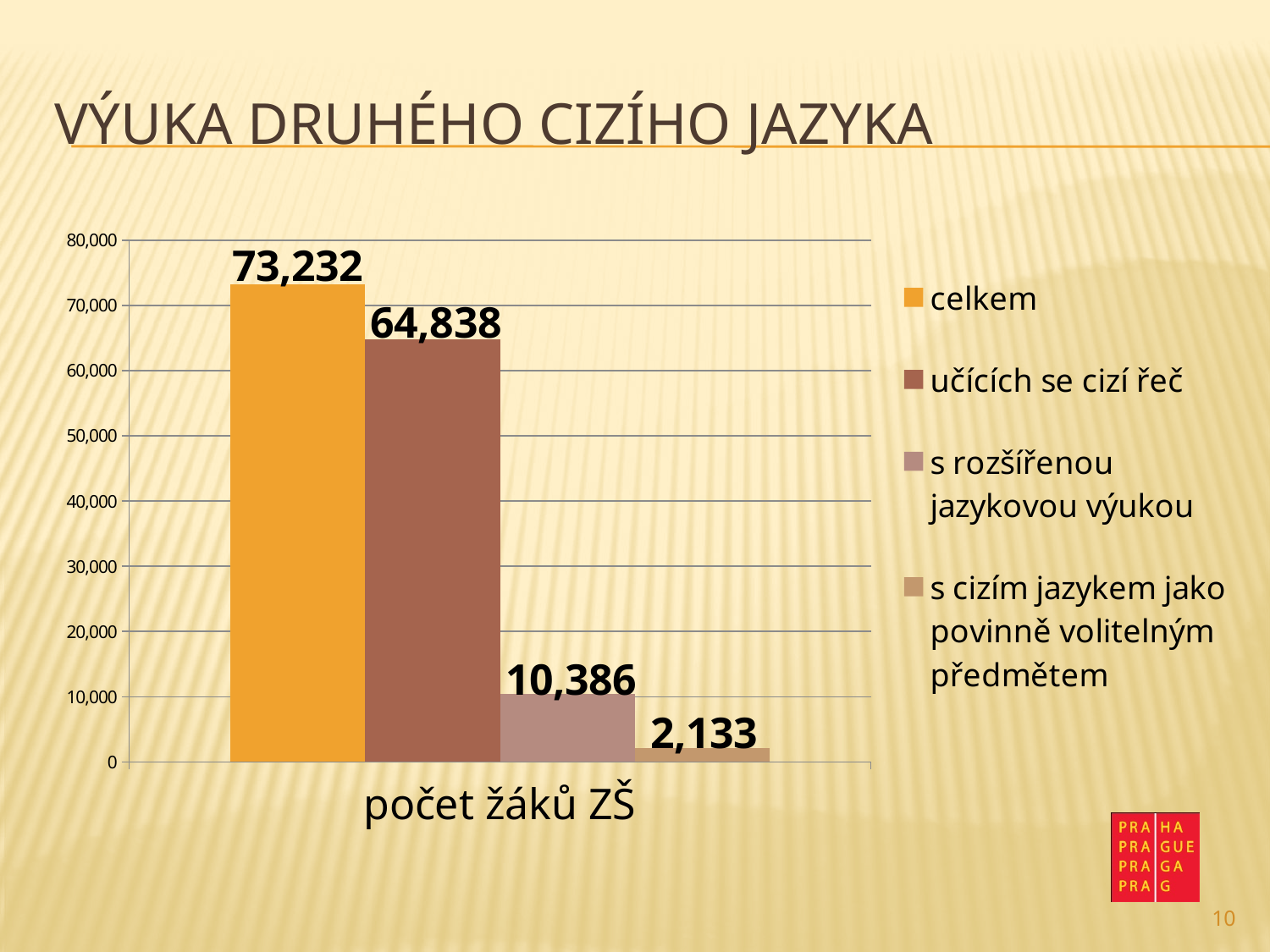
What is the value for "s rozšířenou jazykovou výukou"? 10,386 Which is larger, "učících se cizí řeč" or "s rozšířenou jazykovou výukou"? učících se cizí řeč What is the value for "celkem"? 73,232 What is the value for "učících se cizí řeč"? 64,838 Which series has the lowest value? s cizím jazykem jako povinně volitelným předmětem What kind of chart is shown on the slide? bar chart How many series does the legend list? 4 Which series has the highest value? celkem What is the difference between "s rozšířenou jazykovou výukou" and "s cizím jazykem jako povinně volitelným předmětem"? 8,253 What is the value for "s cizím jazykem jako povinně volitelným předmětem"? 2,133 What is the difference between "celkem" and "učících se cizí řeč"? 8,394 What is the category label shown on the x axis? počet žáků ZŠ